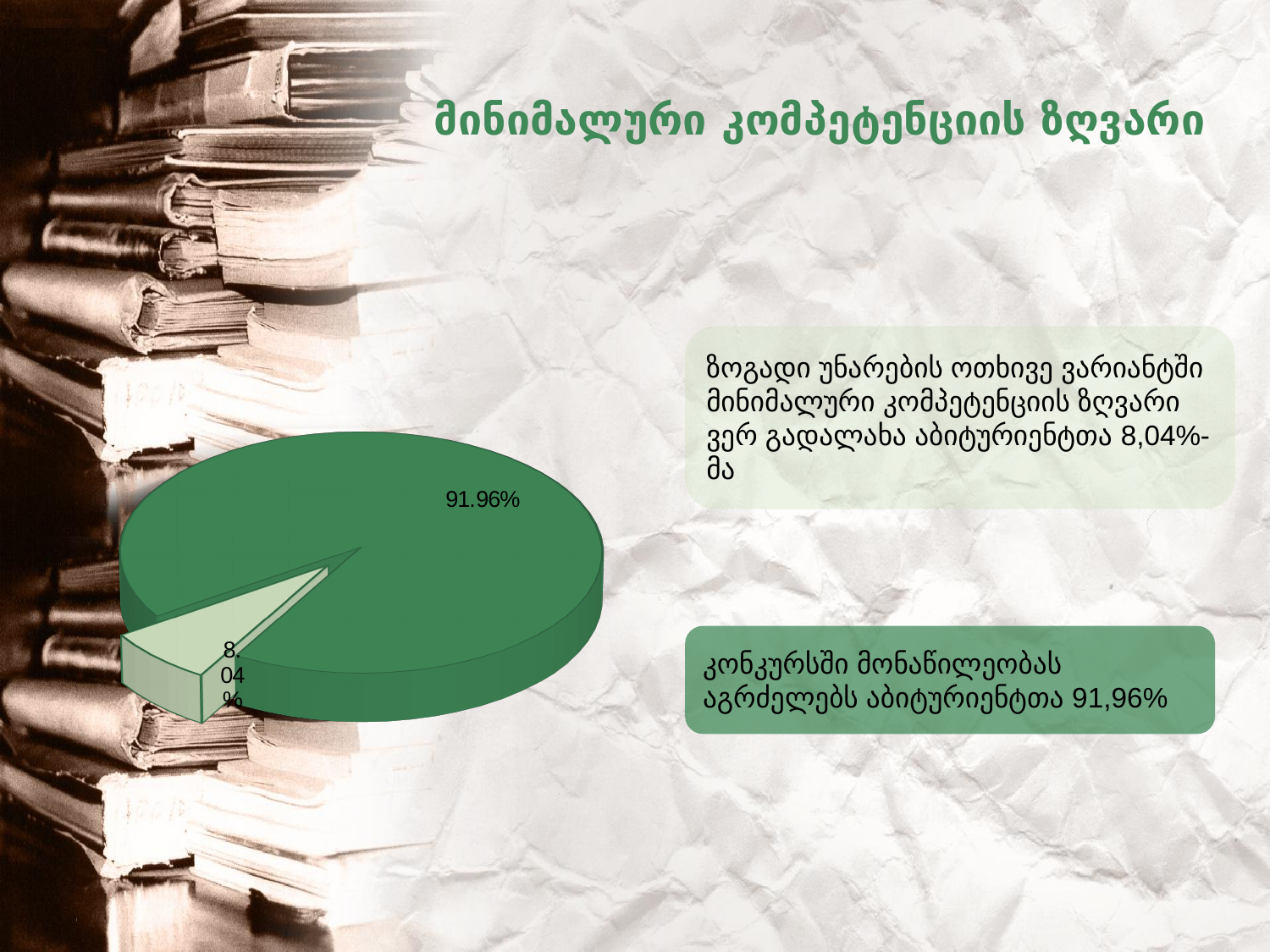
Does the pie chart include a legend? No Which slice of the pie chart is larger, the dark green one or the light green one? the dark green one What value is labelled on the large dark green slice of the pie chart? 91.96% What value is labelled on the small light green slice that is pulled out of the pie chart? 8.04% How many slices does the pie chart have? 2 What is the value of the largest slice in the pie chart? 91.96% What is the difference between the two slice values in the pie chart (91.96% and 8.04%)? 83.92% What kind of chart is shown on the slide? pie chart Which slice of the pie chart is pulled out (exploded) from the rest of the pie? the 8.04% slice What is the value of the smallest slice in the pie chart? 8.04%